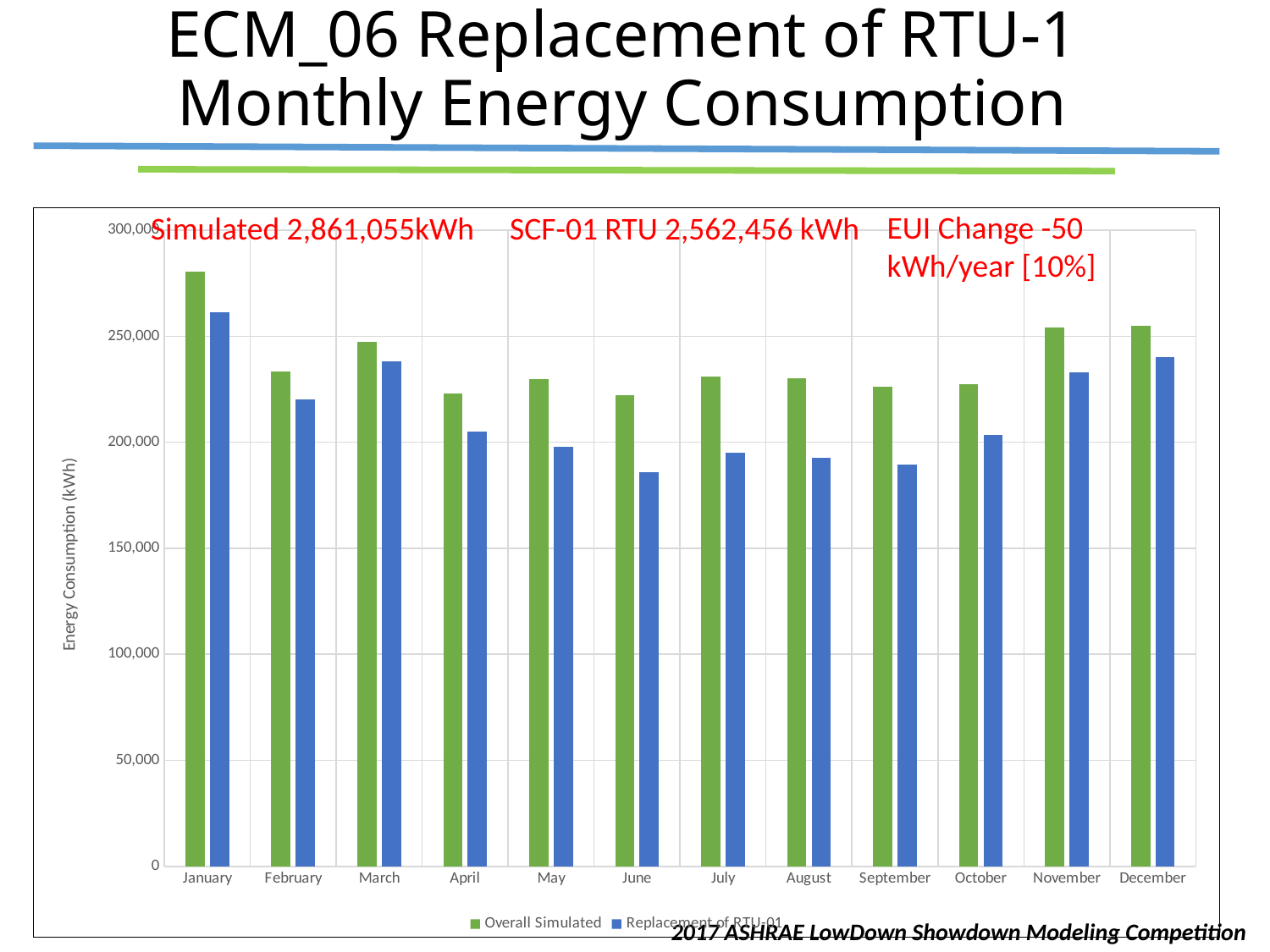
Which month has the highest Replacement of RTU-01 energy consumption? January In January, which series has the larger value: Overall Simulated or Replacement of RTU-01? Overall Simulated Is the Replacement of RTU-01 value for December greater or less than 200,000? greater Is the Overall Simulated value for February greater or less than 250,000? less How many series does the chart's legend list? 2 For the Replacement of RTU-01 series, which is larger: January or December? January What kind of chart is shown on the slide? bar chart What is the label on the chart's vertical axis? Energy Consumption (kWh) How many months are shown on the x axis of the chart? 12 Is the Replacement of RTU-01 value for June greater or less than 200,000? less Which month has the highest Overall Simulated energy consumption? January